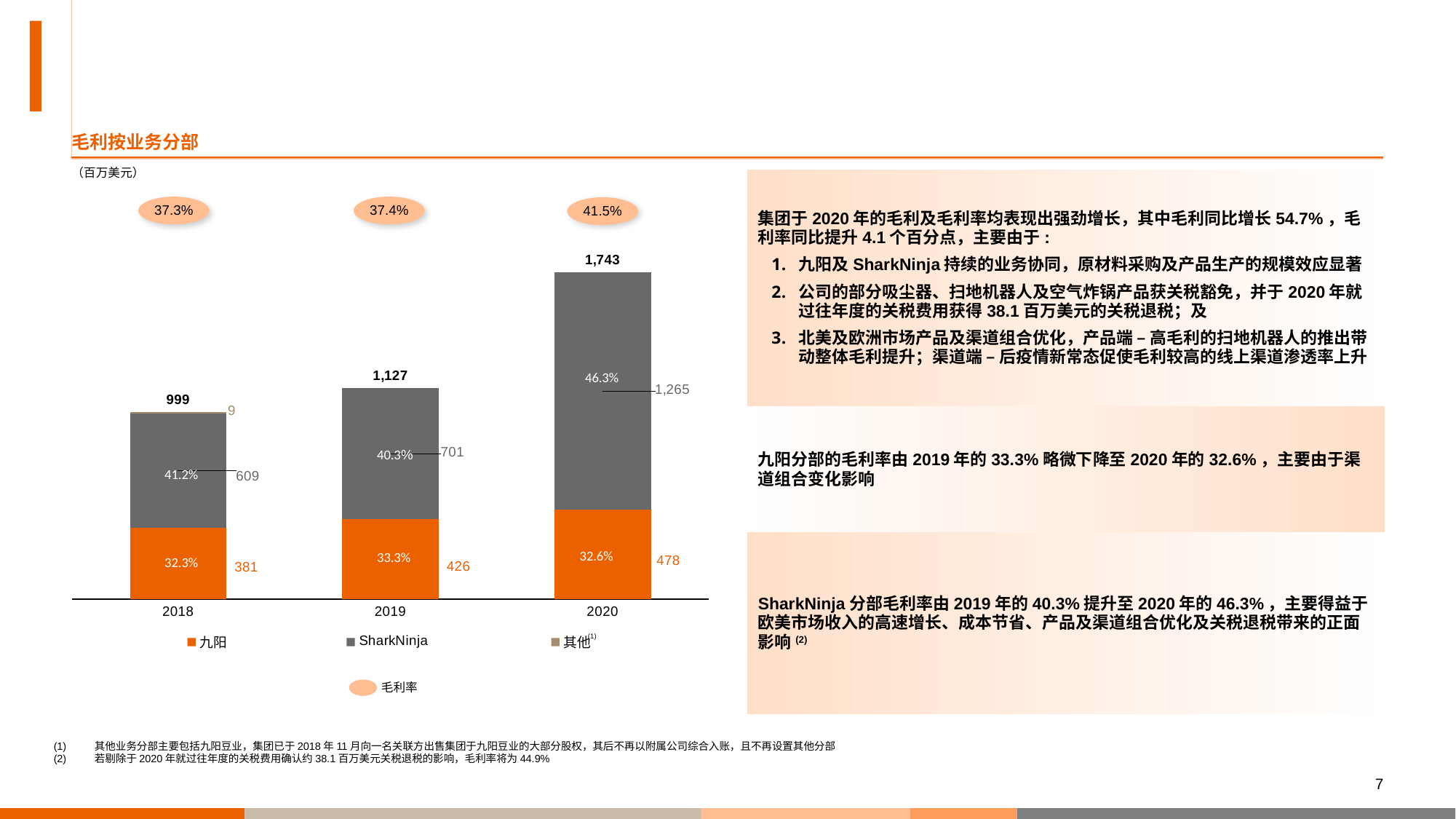
What is the gross profit of 九阳 in 2018? 381 What is the total gross profit shown above the 2019 bar? 1,127 How many series does the bar chart legend list? 3 Which is larger in 2018, the gross profit of 九阳 or of SharkNinja? SharkNinja What gross margin is shown inside the SharkNinja segment for 2019? 40.3% Which year has the highest total gross profit? 2020 How many years are shown on the x axis of the chart? 3 What is the gross profit of SharkNinja in 2020? 1,265 What kind of chart is used to show gross profit by business segment? Stacked bar chart What is the difference between SharkNinja's gross profit in 2020 and in 2019? 564 Does the total gross profit rise or fall from 2018 to 2020? Rise What is the overall gross margin (毛利率) shown for 2020? 41.5%